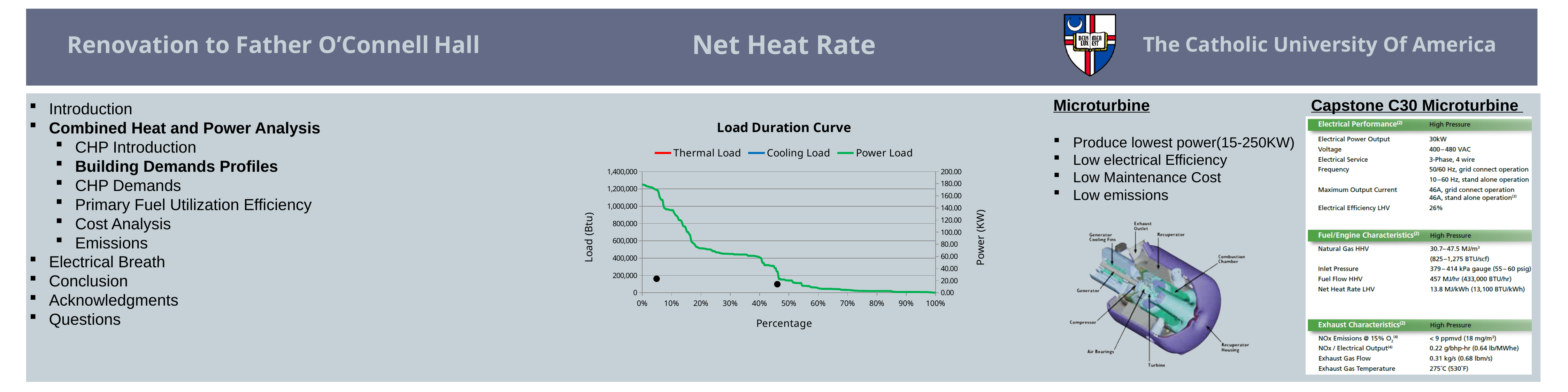
Which series in the Load Duration Curve is drawn in green? Power Load What is the title of the chart on the slide? Load Duration Curve How many series does the legend of the Load Duration Curve list? 3 What is the highest tick shown on the right axis of the Load Duration Curve? 200.00 What kind of chart is the Load Duration Curve? line chart What is the highest tick shown on the left axis of the Load Duration Curve? 1,400,000 Does the Power Load line in the Load Duration Curve rise or fall as the percentage increases? fall